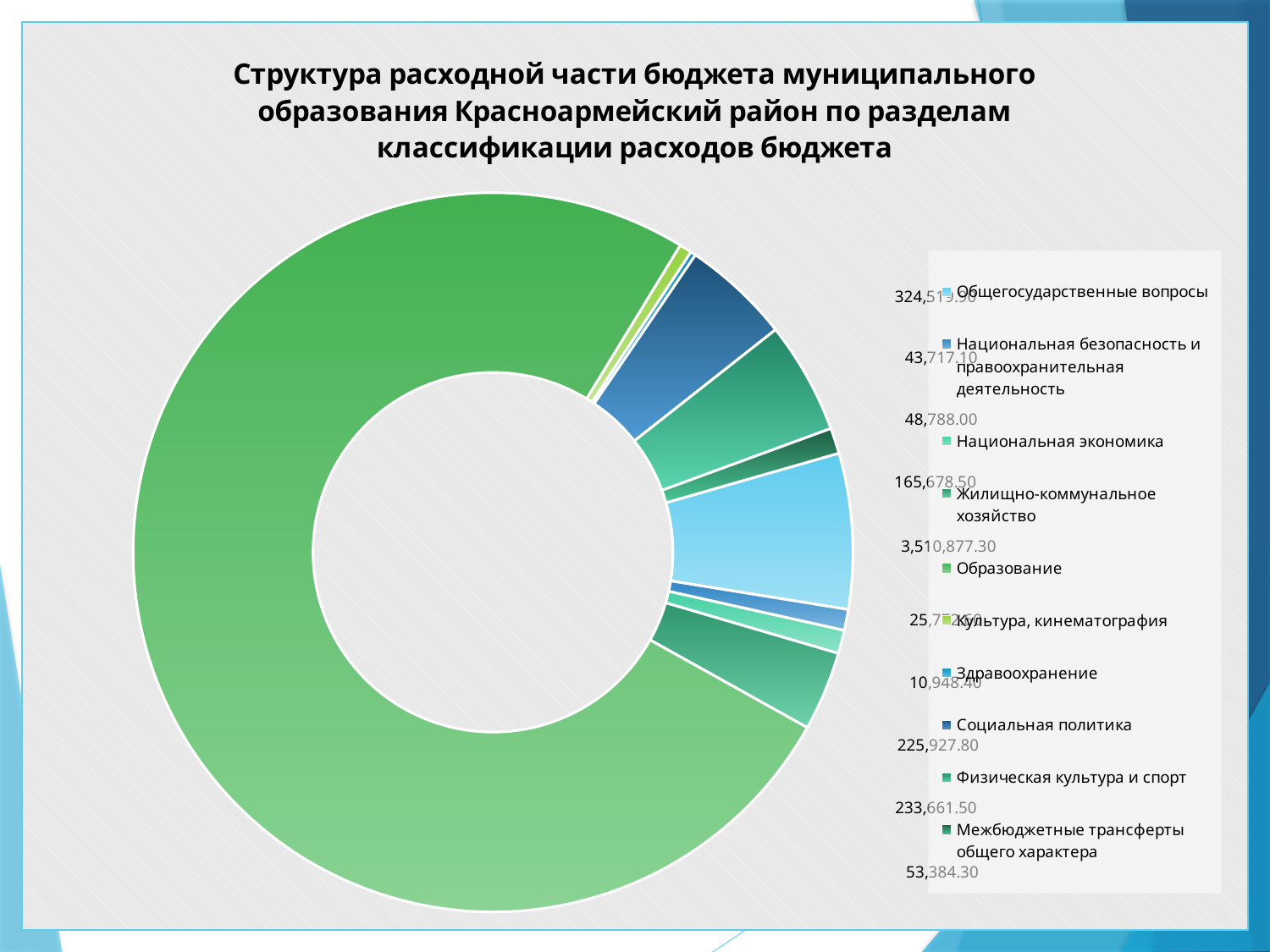
Which legend entry is listed first in the chart's legend? Общегосударственные вопросы Which category accounts for the largest share of the budget expenditure in the chart? Образование What is the title of the chart? Структура расходной части бюджета муниципального образования Красноармейский район по разделам классификации расходов бюджета Which is larger in the chart: the slice for Образование or the slice for Социальная политика? Образование What kind of chart is shown on the slide? Doughnut (pie) chart How many categories does the legend of the chart list? 10 What is the value shown for Образование? 3,510,877.30